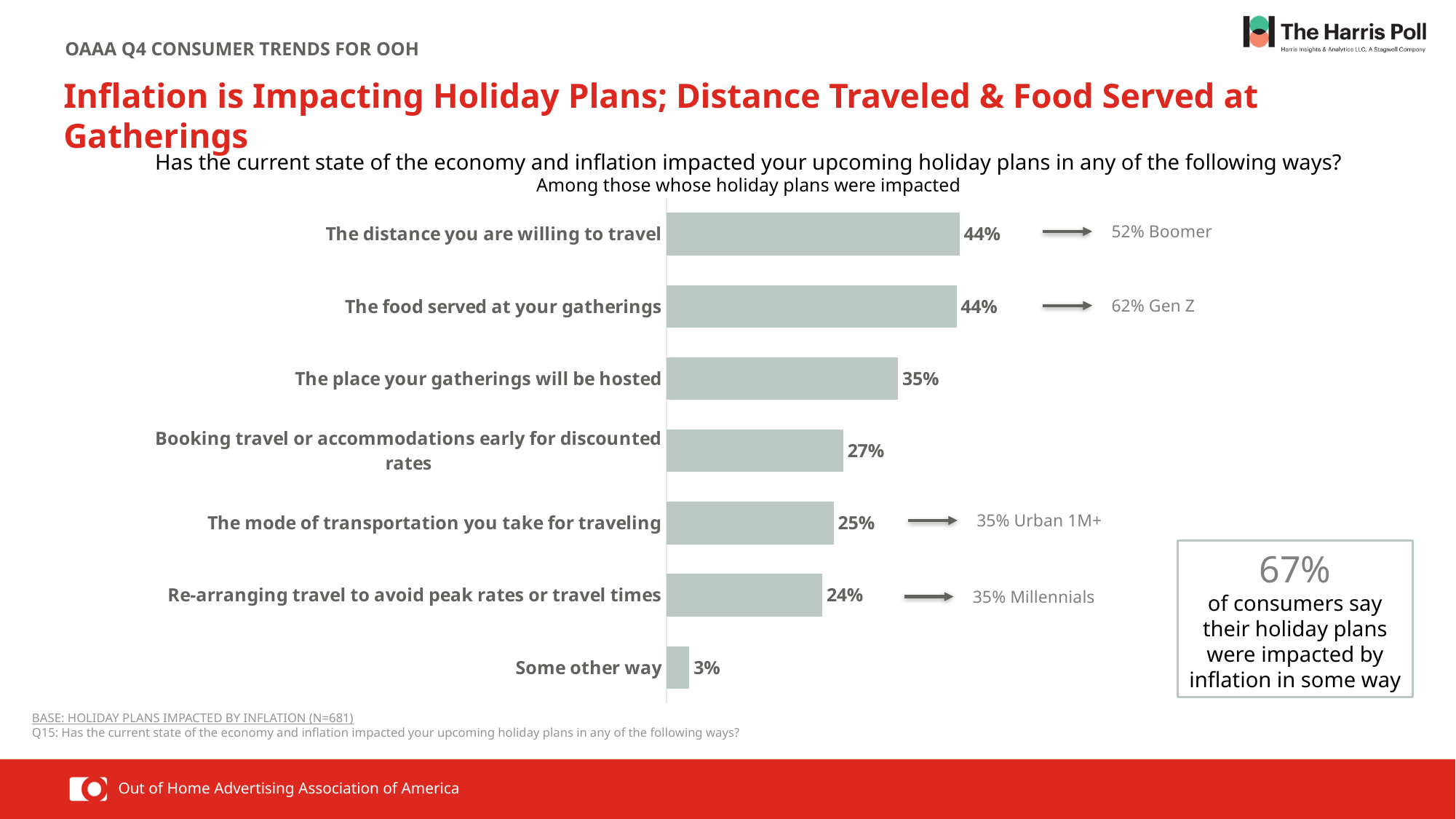
What kind of chart is shown on the slide? Bar chart What is the value for 'The place your gatherings will be hosted'? 35% What is the difference between 'The place your gatherings will be hosted' and 'Re-arranging travel to avoid peak rates or travel times'? 11% Do the values rise or fall going from the top bar to the bottom bar? Fall What percentage said inflation impacted booking travel or accommodations early for discounted rates? 27% What percentage of Gen Z is called out next to 'The food served at your gatherings'? 62% Which is larger: 'The mode of transportation you take for traveling' or 'Booking travel or accommodations early for discounted rates'? Booking travel or accommodations early for discounted rates According to the callout box, what percentage of consumers say their holiday plans were impacted by inflation in some way? 67% What percentage of respondents said inflation impacted the distance they are willing to travel? 44% Which category has the lowest value in the chart? Some other way What is the value for 'Some other way'? 3% How many categories are shown in the bar chart? 7